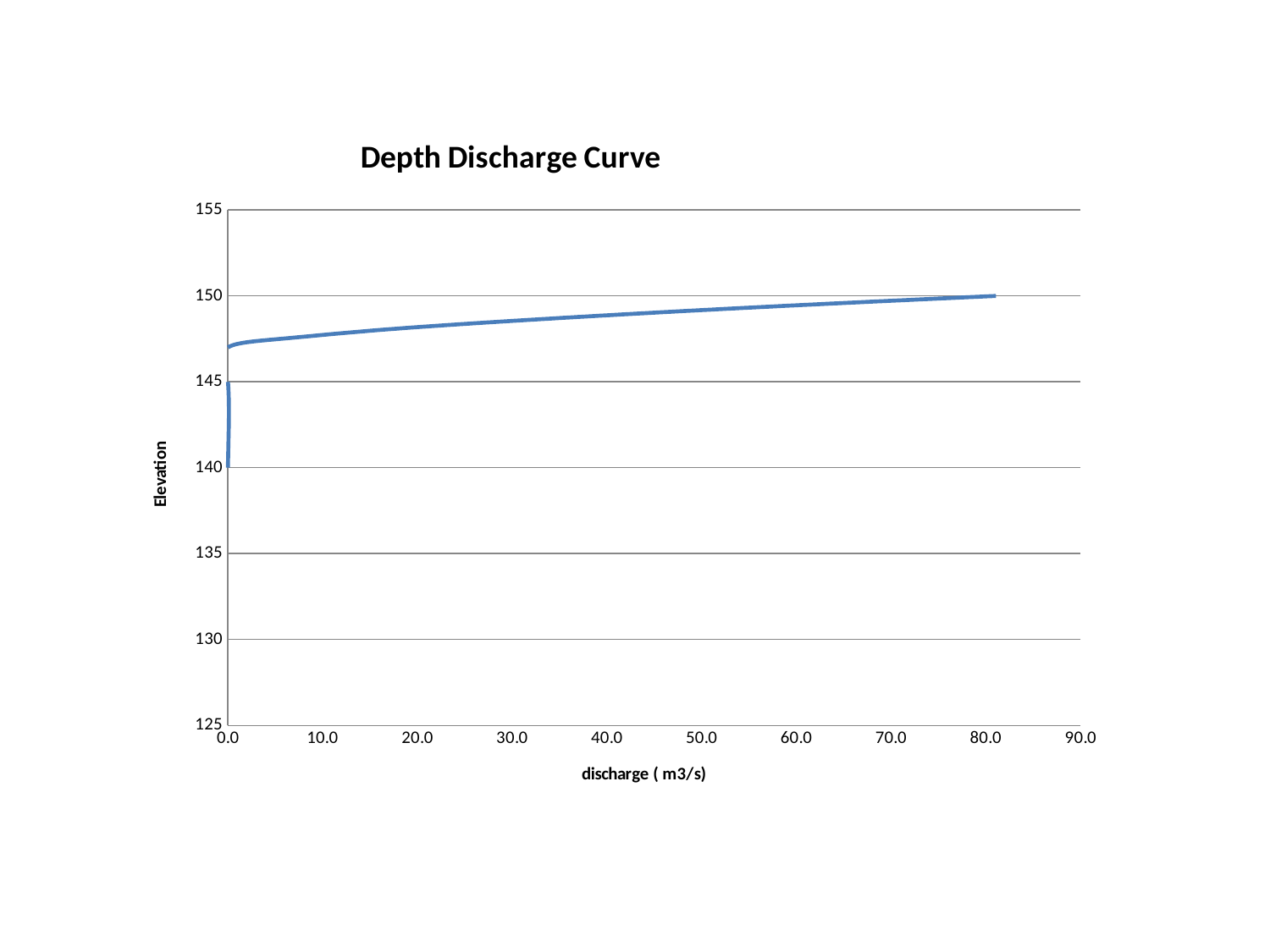
Is the elevation at a discharge of 40.0 m3/s greater or less than 145? greater What is the label of the x axis of the chart? discharge ( m3/s) Does the elevation rise or fall as discharge increases along the x axis? rise What kind of chart is shown on the slide? line chart Is the lowest elevation plotted on the curve greater or less than 135? greater What is the title of the chart? Depth Discharge Curve Is the elevation at a discharge of 40.0 m3/s greater or less than 150? less